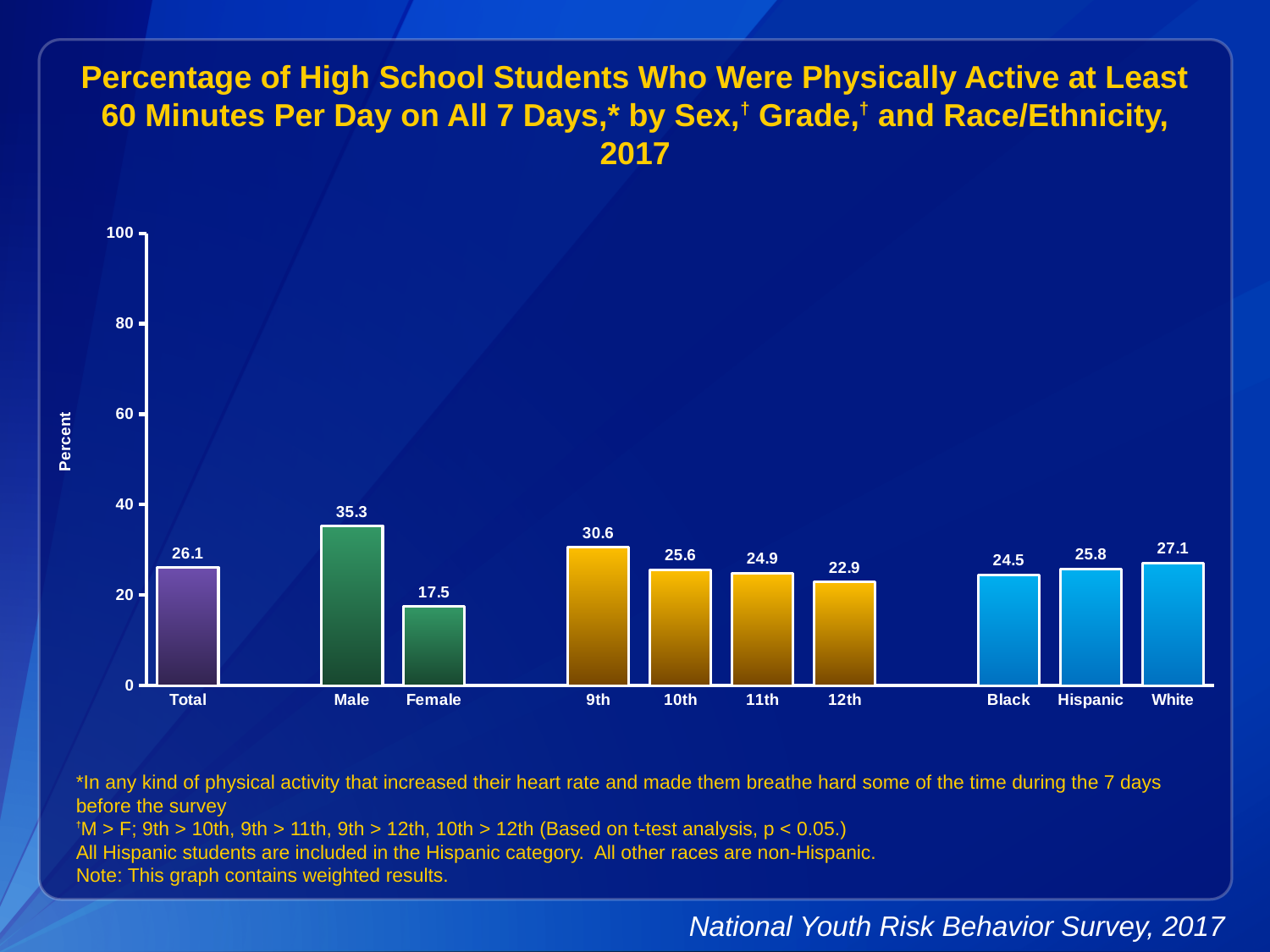
What is the value for Female? 17.5 What is the value for Hispanic students? 25.8 Is the value for Total greater or less than 40? less What is the value for 12th grade? 22.9 Which is larger, the value for White or the value for Black? White What kind of chart is shown on the slide? bar chart What is the difference between the values for 9th grade and 12th grade? 7.7 Which category has the highest value? Male What is the difference between the values for Male and Female? 17.8 How many bars are shown in the chart? 10 Which category has the lowest value? Female What is the value for Male? 35.3